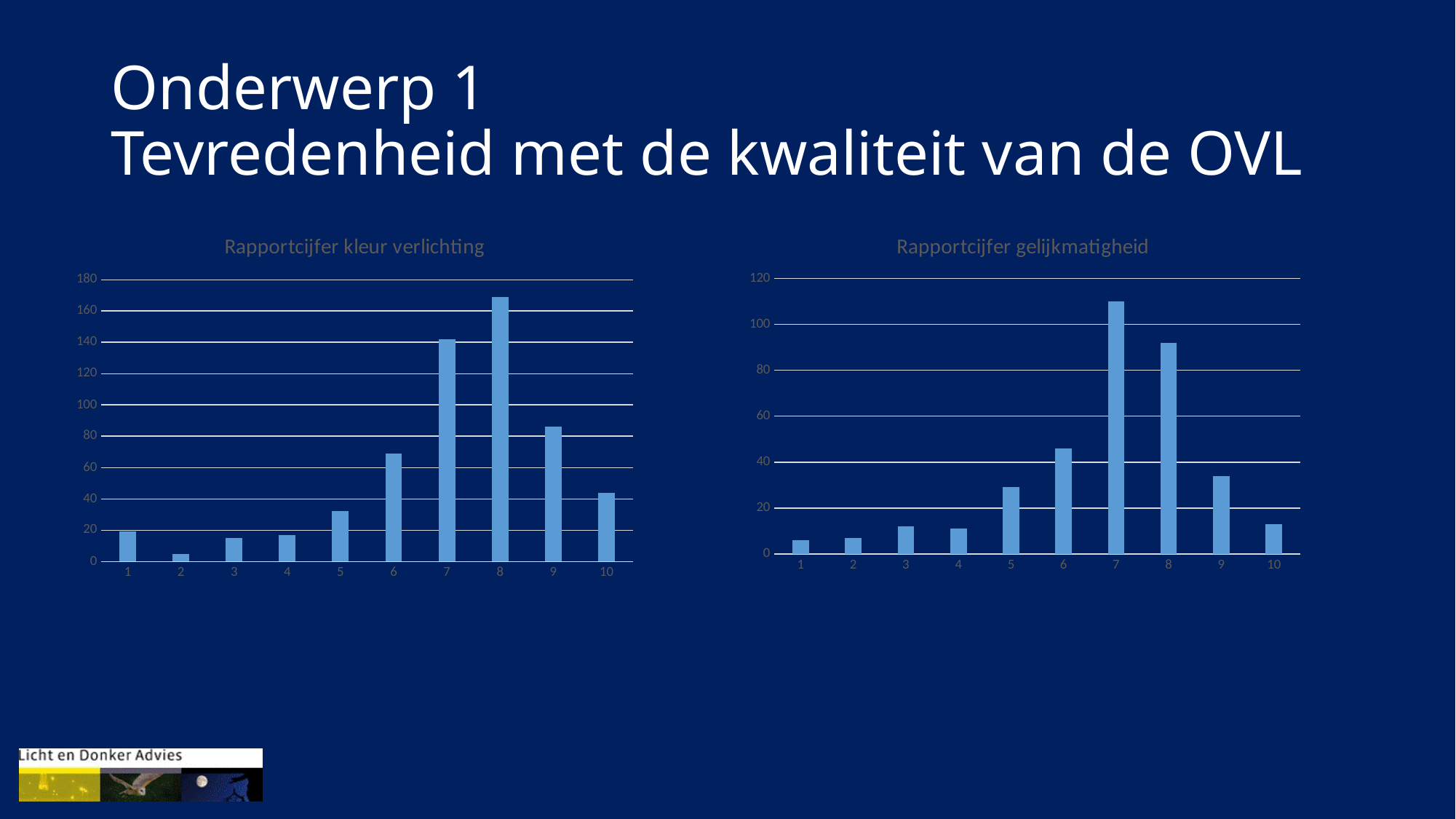
In the 'Rapportcijfer gelijkmatigheid' chart, is the value for 7 greater or less than 100? greater In the 'Rapportcijfer gelijkmatigheid' chart, which is larger, the value for 6 or the value for 9? 6 How many categories are shown on the x axis of the 'Rapportcijfer kleur verlichting' chart? 10 What kind of chart is the 'Rapportcijfer kleur verlichting' chart? bar chart What is the title of the chart on the right side of the slide? Rapportcijfer gelijkmatigheid In the 'Rapportcijfer kleur verlichting' chart, which category has the lowest value? 2 In the 'Rapportcijfer gelijkmatigheid' chart, which category has the highest value? 7 In the 'Rapportcijfer kleur verlichting' chart, is the value for 8 greater or less than 160? greater In the 'Rapportcijfer gelijkmatigheid' chart, is the value for 8 greater or less than 100? less In the 'Rapportcijfer kleur verlichting' chart, which category has the highest value? 8 In the 'Rapportcijfer kleur verlichting' chart, which is larger, the value for 7 or the value for 9? 7